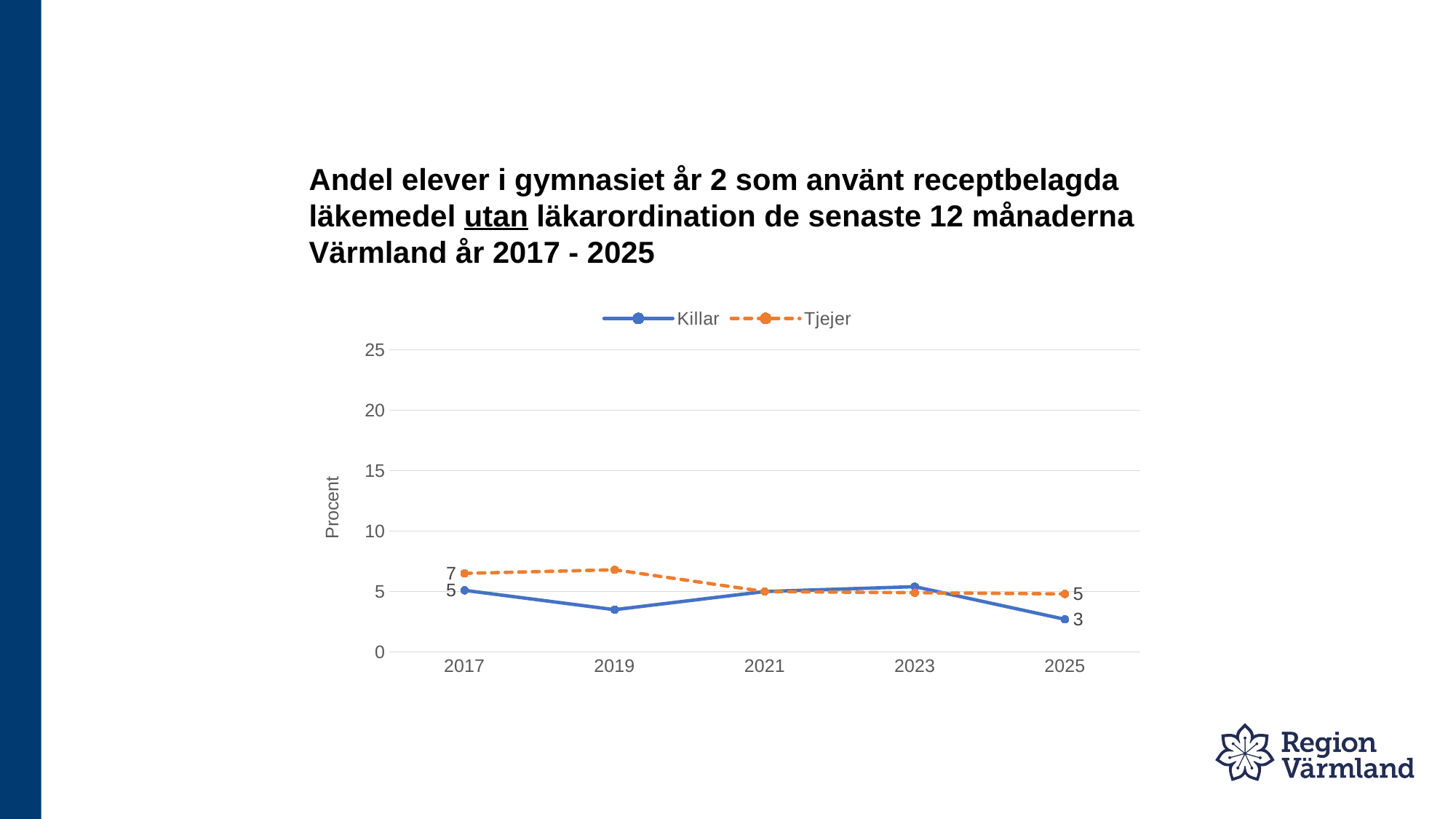
Is the value for Tjejer in 2019 greater or less than 5? greater How many years are shown on the x axis? 5 What is the difference between the Tjejer and Killar values in 2017? 2 How many series does the legend list? 2 In 2025, which series has the higher value, Killar or Tjejer? Tjejer What is the value for Killar in 2017? 5 What is the value for Killar in 2025? 3 What is the value for Tjejer in 2017? 7 By how much did the Killar value change from 2017 to 2025? 2 What is the value for Tjejer in 2025? 5 What kind of chart is shown on the slide? line chart Is the value for Killar in 2019 greater or less than 5? less